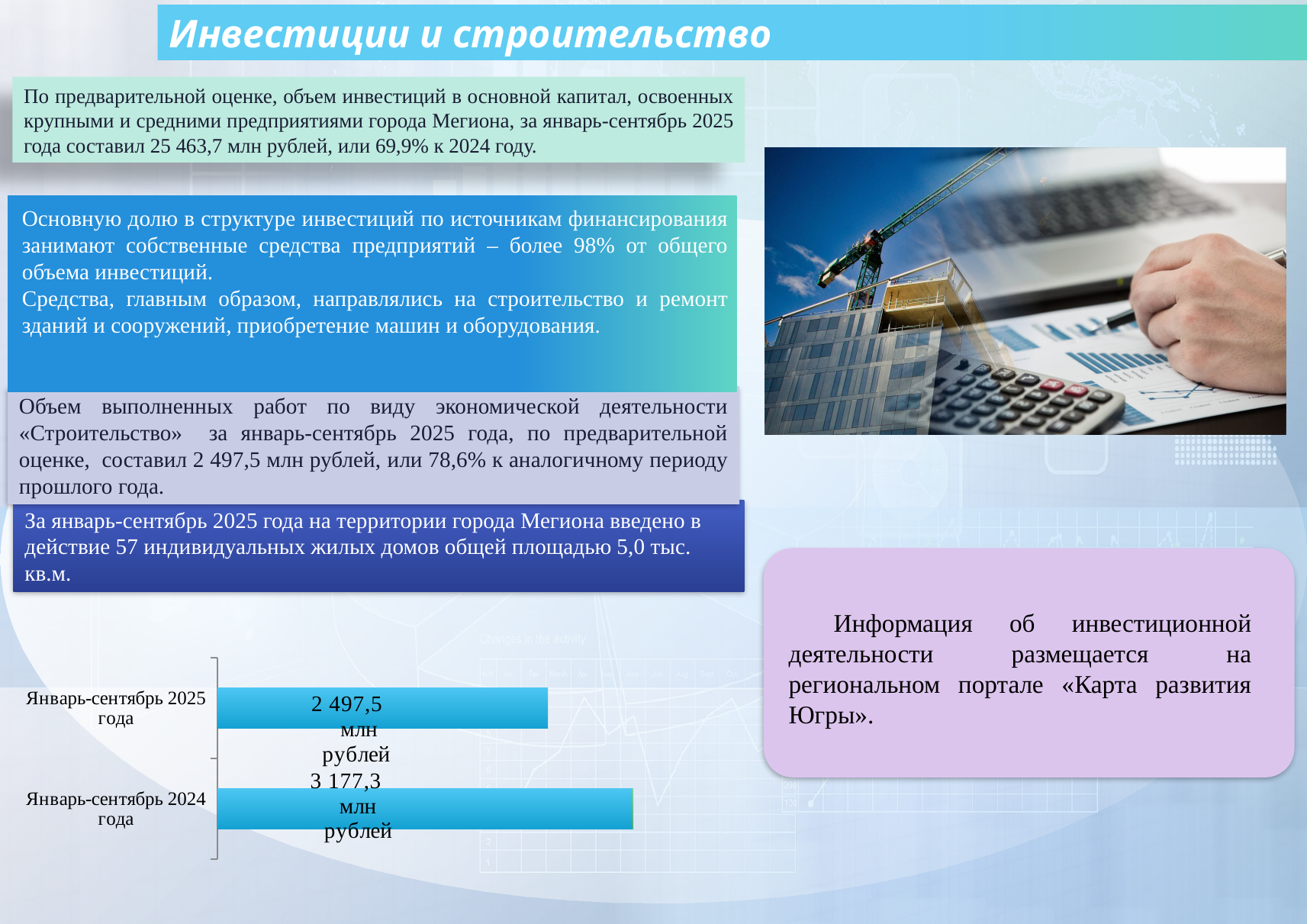
Which category has the highest value on the bar chart? Январь-сентябрь 2024 года What is the value for Январь-сентябрь 2025 года on the bar chart? 2 497,5 млн рублей Are the bars on the chart oriented horizontally or vertically? Horizontally What kind of chart is shown at the bottom of the slide? Bar chart What colour are the bars on the chart? Blue What is the value for Январь-сентябрь 2024 года on the bar chart? 3 177,3 млн рублей How many categories are shown on the bar chart? 2 Which category has the lowest value on the bar chart? Январь-сентябрь 2025 года What is the difference between the values for Январь-сентябрь 2024 года and Январь-сентябрь 2025 года on the bar chart? 679,8 млн рублей Which is larger on the bar chart: the value for Январь-сентябрь 2025 года or for Январь-сентябрь 2024 года? Январь-сентябрь 2024 года